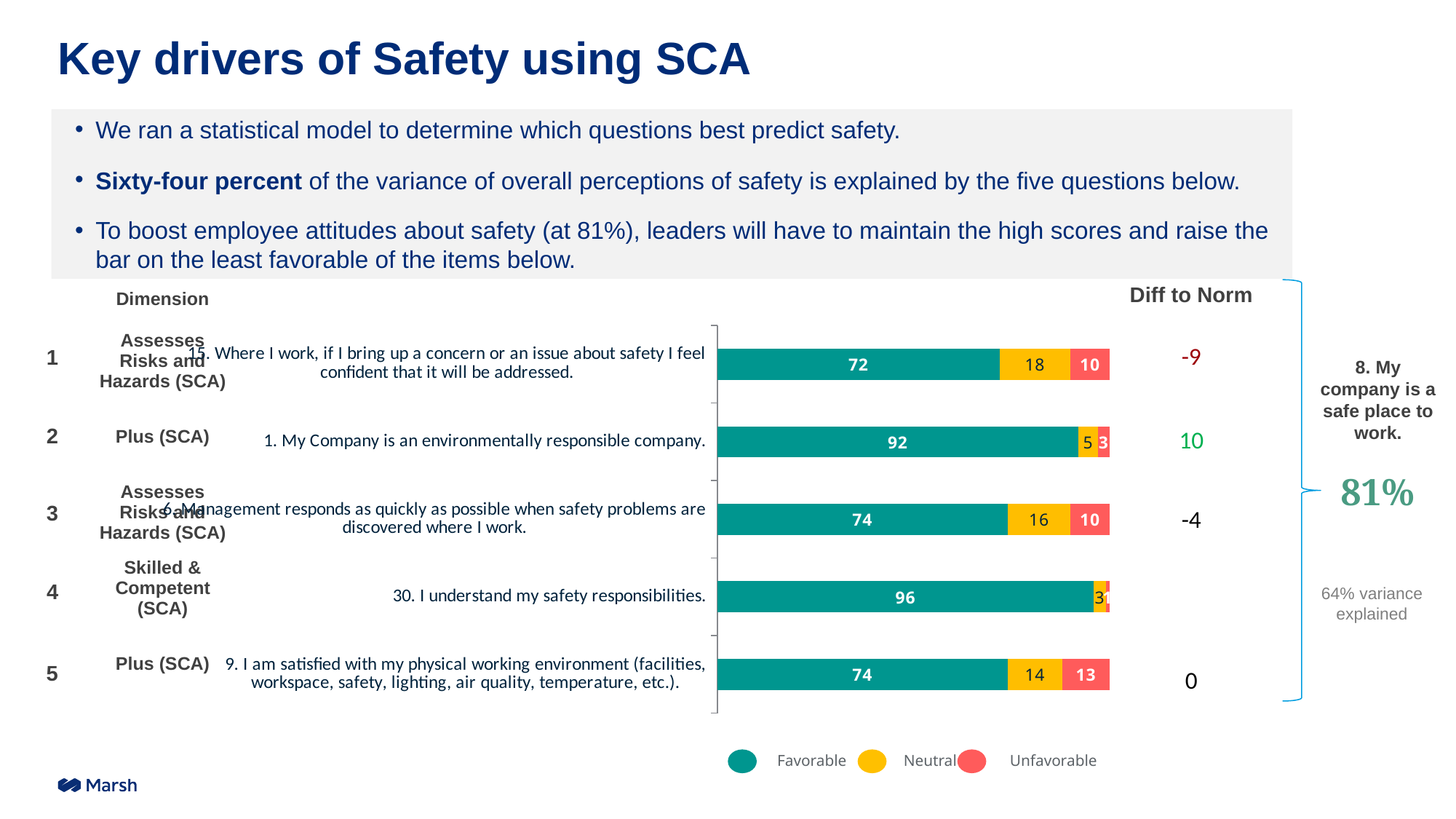
What kind of chart is shown on the slide? Stacked bar chart Which has the larger Unfavorable value: "9. I am satisfied with my physical working environment" or "6. Management responds as quickly as possible when safety problems are discovered where I work."? 9. I am satisfied with my physical working environment What is the difference between the Favorable values for "1. My Company is an environmentally responsible company." and "15. Where I work, if I bring up a concern or an issue about safety I feel confident that it will be addressed."? 20 Which item has the lowest Favorable value? 15. Where I work, if I bring up a concern or an issue about safety I feel confident that it will be addressed. What are the three legend entries of the chart? Favorable, Neutral, Unfavorable What is the Unfavorable value for "9. I am satisfied with my physical working environment"? 13 What is the Neutral value for "15. Where I work, if I bring up a concern or an issue about safety I feel confident that it will be addressed."? 18 How many series does the legend list? 3 Which item has the highest Favorable value? 30. I understand my safety responsibilities. What is the Favorable value for "30. I understand my safety responsibilities."? 96 How many items (bars) are shown in the chart? 5 What is the total of the stacked bar for "1. My Company is an environmentally responsible company."? 100